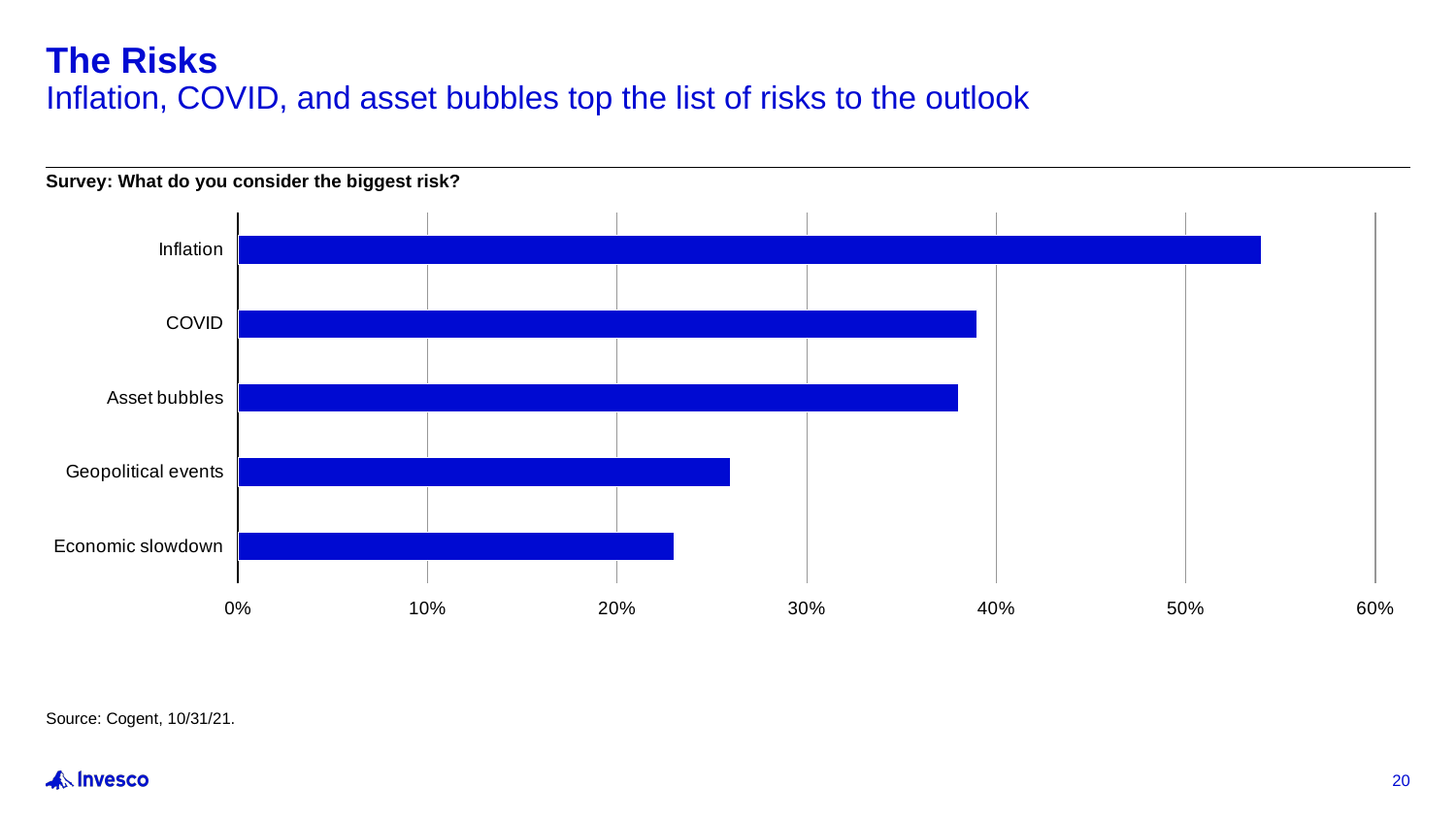
How many risk categories are plotted in the chart? 5 Is the value for COVID greater or less than 30%? greater Which risk category has the highest value in the chart? Inflation Which risk category has the lowest value in the chart? Economic slowdown Is the value for Geopolitical events greater or less than 30%? less What type of chart is shown on the slide? Bar chart Which has a larger value, Inflation or COVID? Inflation What is the survey question shown as the chart's title? What do you consider the biggest risk? Is the value for Economic slowdown greater or less than 20%? greater Which has a larger value, Asset bubbles or Economic slowdown? Asset bubbles